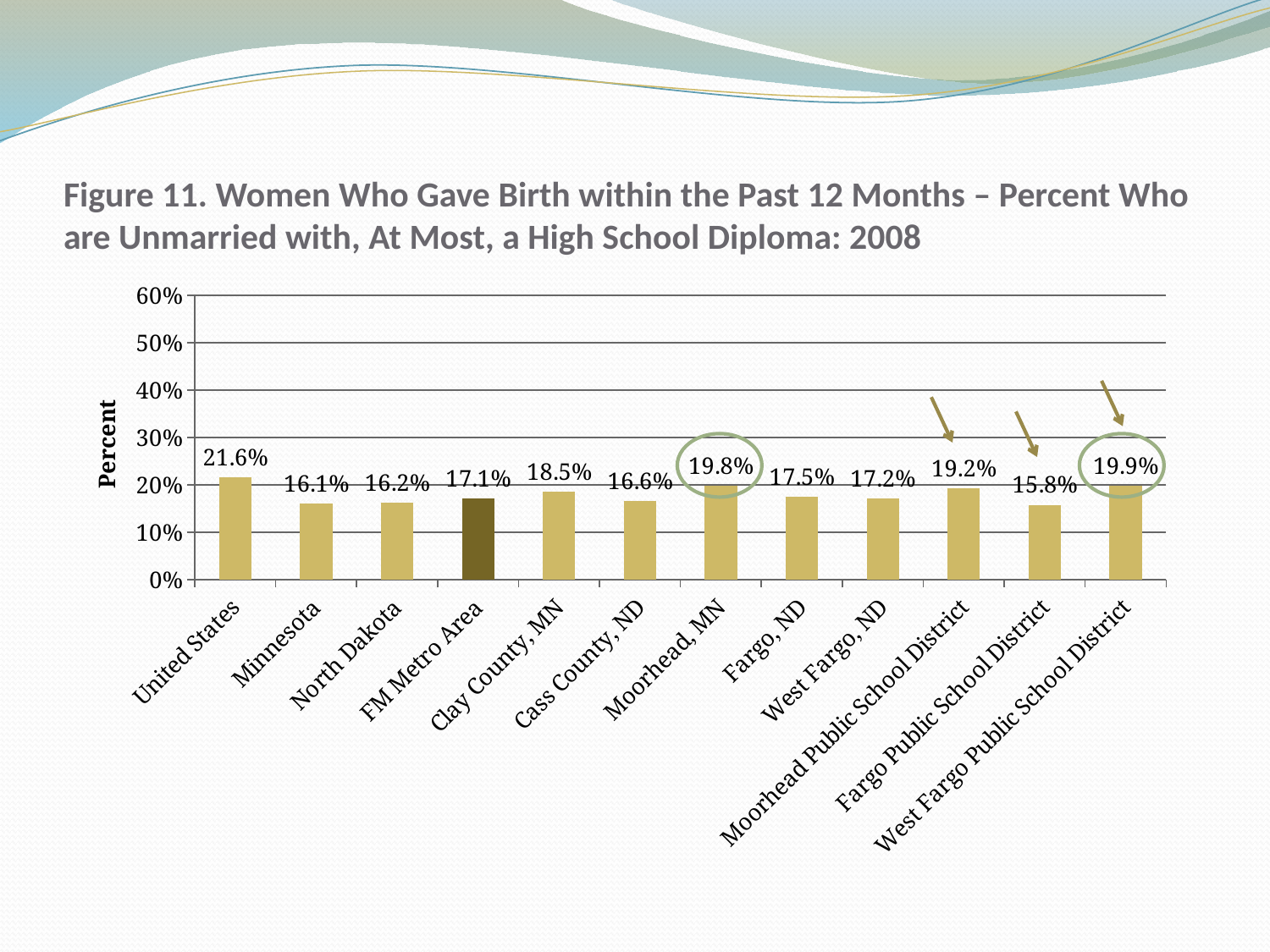
What is the value for the FM Metro Area? 17.1% Is the value for Fargo, ND greater or less than 20%? less What is the label of the vertical axis? Percent Which category has the lowest value? Fargo Public School District What is the value for Moorhead, MN? 19.8% Which is larger, the value for Clay County, MN or the value for Cass County, ND? Clay County, MN What kind of chart is shown on the slide? bar chart What is the difference between the values for the United States and Minnesota? 5.5% Which category has the highest value? United States What is the value for the West Fargo Public School District? 19.9% How many categories are shown on the x axis? 12 What is the value for the United States? 21.6%